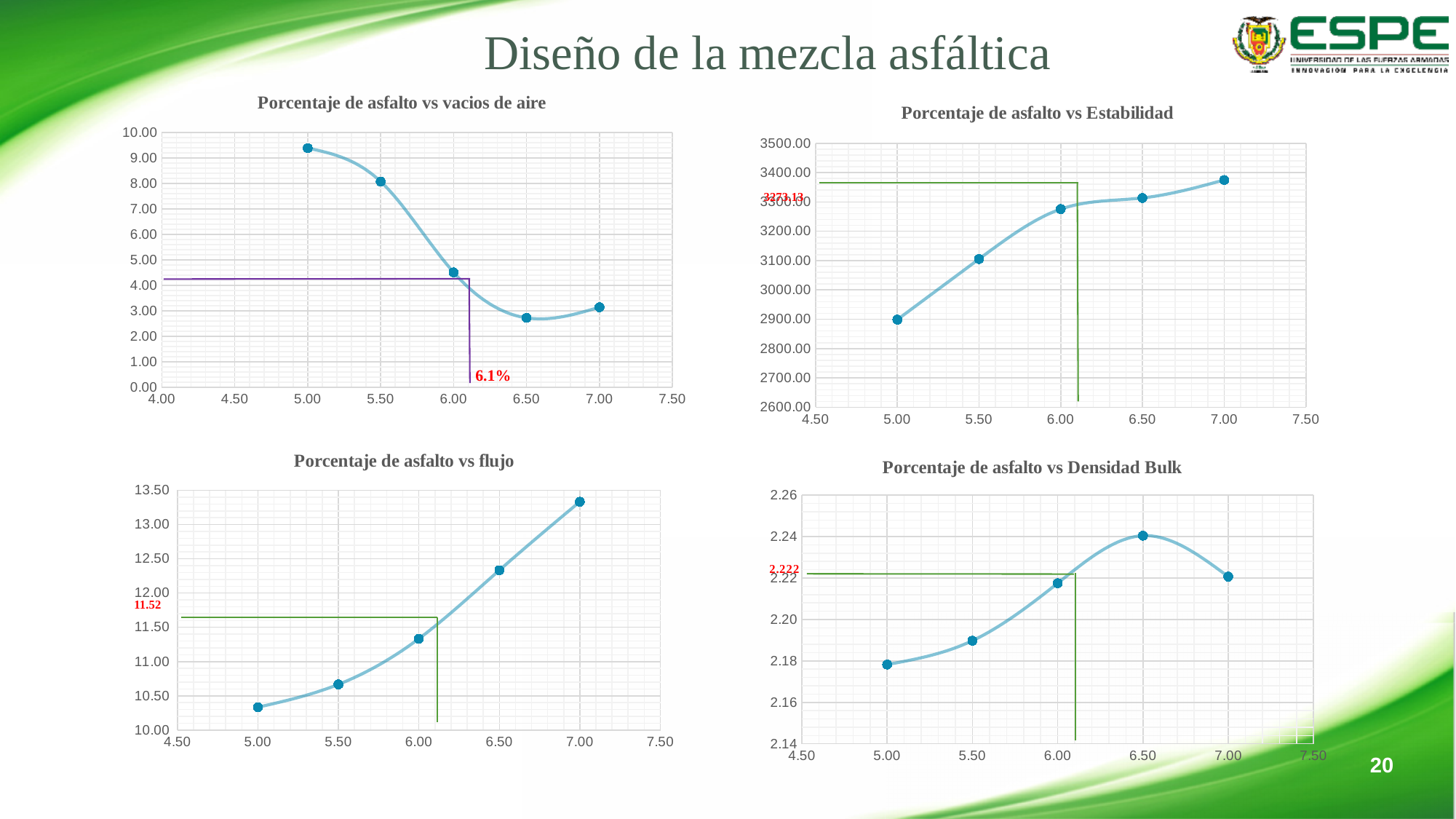
How many charts are on the slide? 4 In the chart 'Porcentaje de asfalto vs vacios de aire', at which asphalt percentage is the air void value lowest? 6.50 In the chart 'Porcentaje de asfalto vs vacios de aire', is the value at 5.00 greater or less than 9.00? greater In the chart 'Porcentaje de asfalto vs vacios de aire', what percentage is annotated in red next to the vertical line? 6.1% In the chart 'Porcentaje de asfalto vs flujo', which has the larger flow value: 5.00 or 7.00? 7.00 In the chart 'Porcentaje de asfalto vs flujo', do the values rise or fall as the asphalt percentage increases? Rise In the chart 'Porcentaje de asfalto vs vacios de aire', how many data points are plotted? 5 In the chart 'Porcentaje de asfalto vs Densidad Bulk', at which asphalt percentage is the density highest? 6.50 In the chart 'Porcentaje de asfalto vs vacios de aire', at which asphalt percentage is the air void value highest? 5.00 In the chart 'Porcentaje de asfalto vs Estabilidad', do the values rise or fall as the asphalt percentage increases from 5.00 to 7.00? Rise What kind of chart is 'Porcentaje de asfalto vs Estabilidad'? Line chart In the chart 'Porcentaje de asfalto vs Estabilidad', is the value at 7.00 greater or less than 3300.00? greater